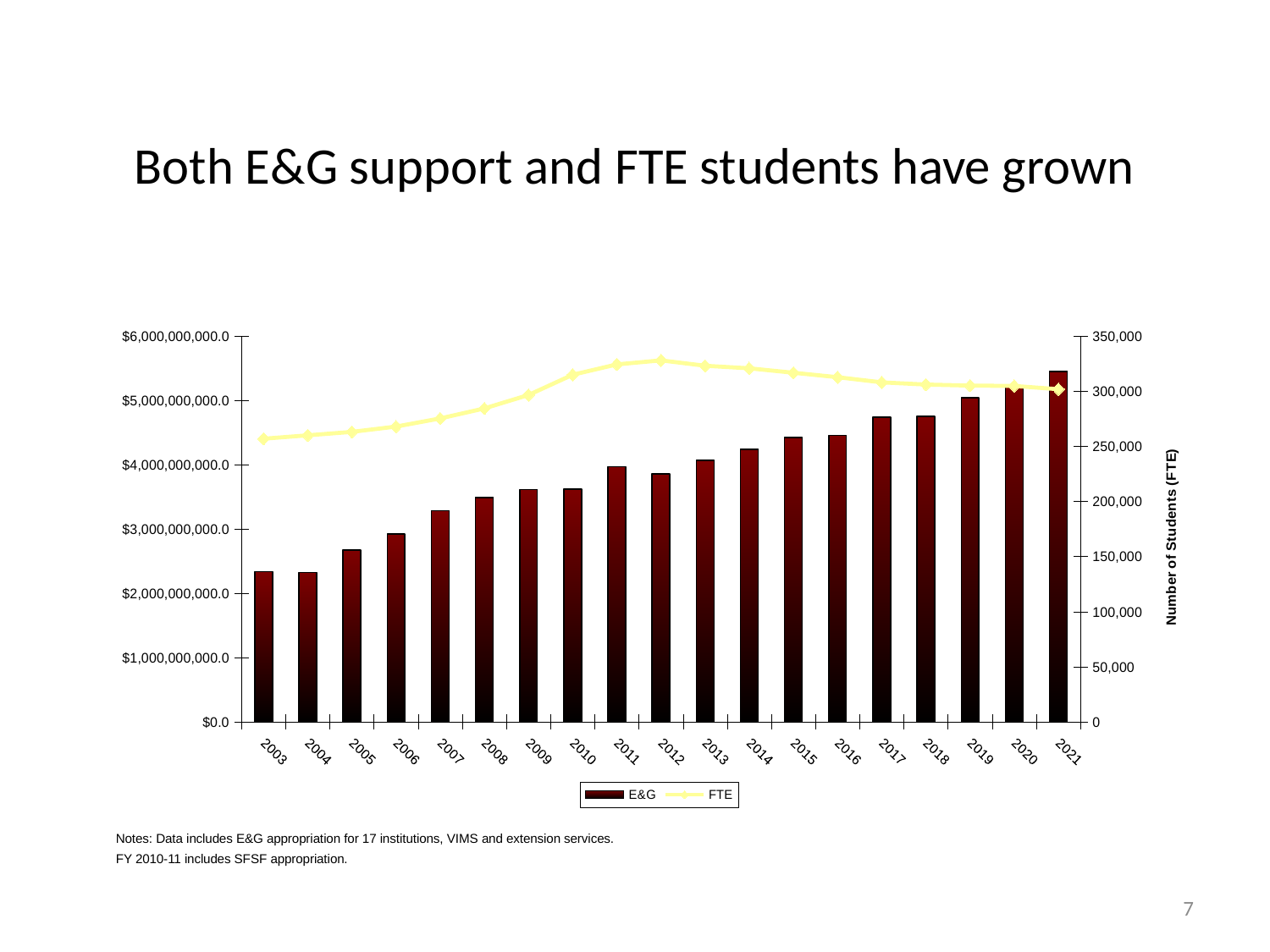
How many years are shown along the x axis? 19 How many series does the legend list? 2 In which year does the FTE line reach its highest point? 2012 Is the E&G value for 2021 greater or less than $5,000,000,000.0? greater Overall, do the E&G bars rise or fall from 2003 to 2021? rise Is the E&G value for 2017 greater or less than $4,000,000,000.0? greater Which year has the highest E&G bar? 2021 What is the title of the right-hand vertical axis? Number of Students (FTE) What kind of chart is shown on the slide? A combined bar and line chart Which year has the larger E&G bar, 2011 or 2012? 2011 Is the E&G value for 2003 greater or less than $3,000,000,000.0? less